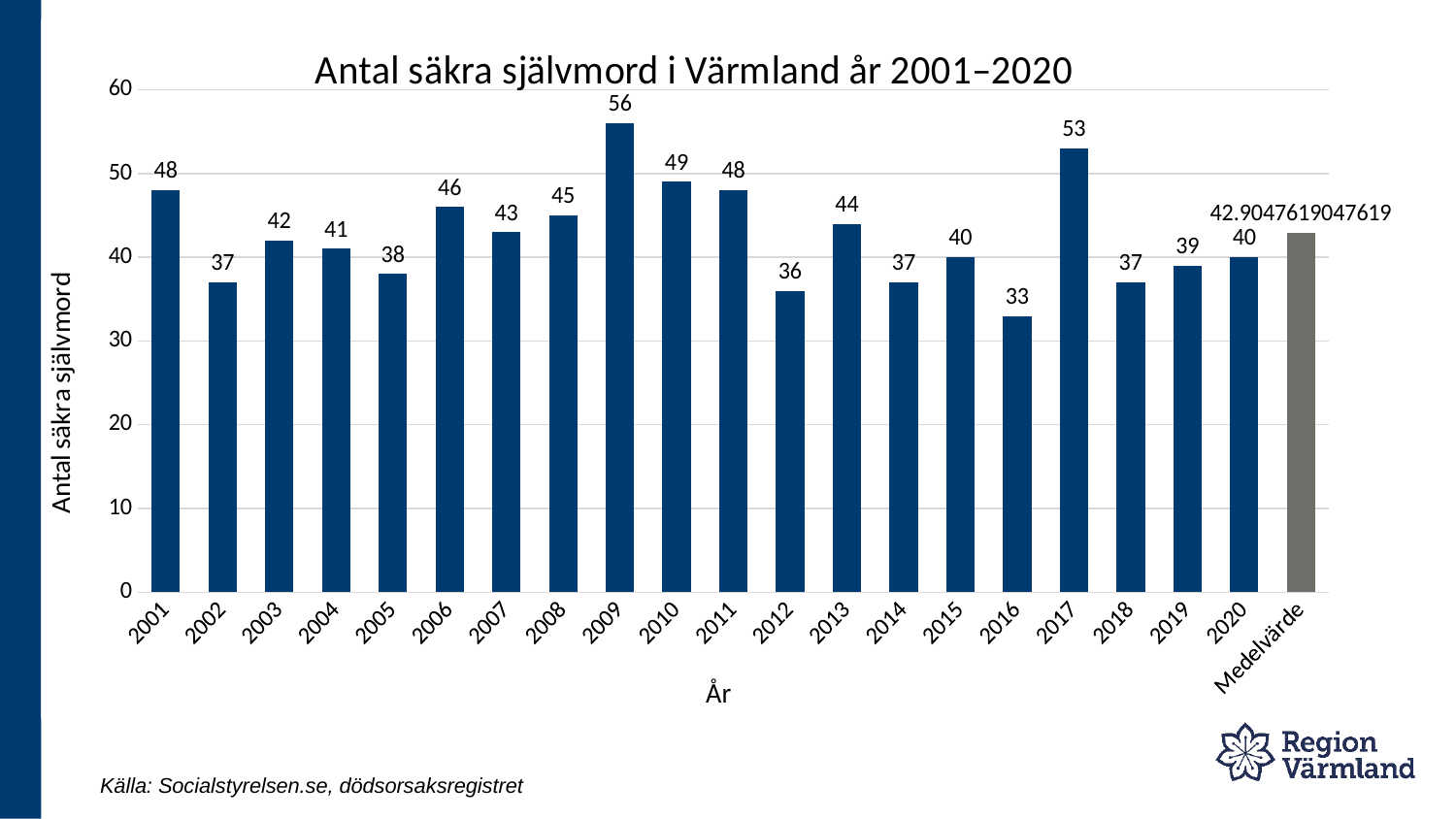
Is the value for 2012 greater or less than 40? less How many bars are shown in the chart? 21 What kind of chart is this? bar chart Which is larger, the value for 2006 or the value for 2013? 2006 What is the value for 2009? 56 What is the value shown for Medelvärde? 42.9047619047619 What is the difference between the values for 2017 and 2018? 16 Which year has the lowest value? 2016 Do the values rise or fall from 2014 to 2015? rise What is the title of the chart? Antal säkra självmord i Värmland år 2001–2020 What is the value for 2016? 33 Which year has the highest value? 2009